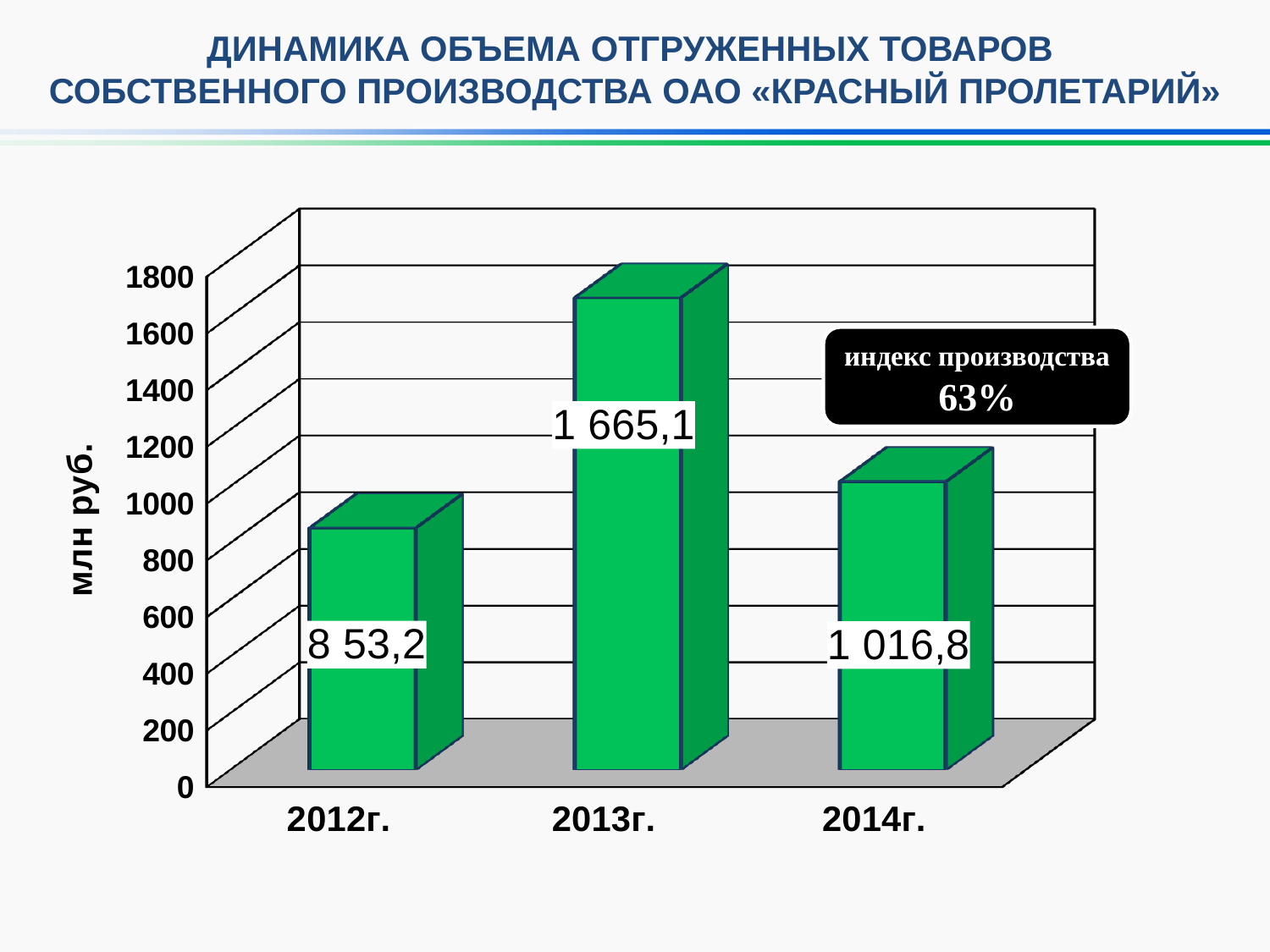
What is the value for 2012г.? 853,2 What is the value for 2013г.? 1 665,1 What kind of chart is shown on the slide? bar chart How many years are shown on the chart? 3 What is the difference between the values for 2013г. and 2014г.? 648,3 What is the difference between the values for 2014г. and 2012г.? 163,6 Is the value for 2013г. greater or less than 1600? greater Which year has the lowest value? 2012г. Which is larger, the value for 2012г. or the value for 2014г.? 2014г. What is the value for 2014г.? 1 016,8 Which year has the highest value? 2013г. What unit is shown on the vertical axis of the chart? млн руб.